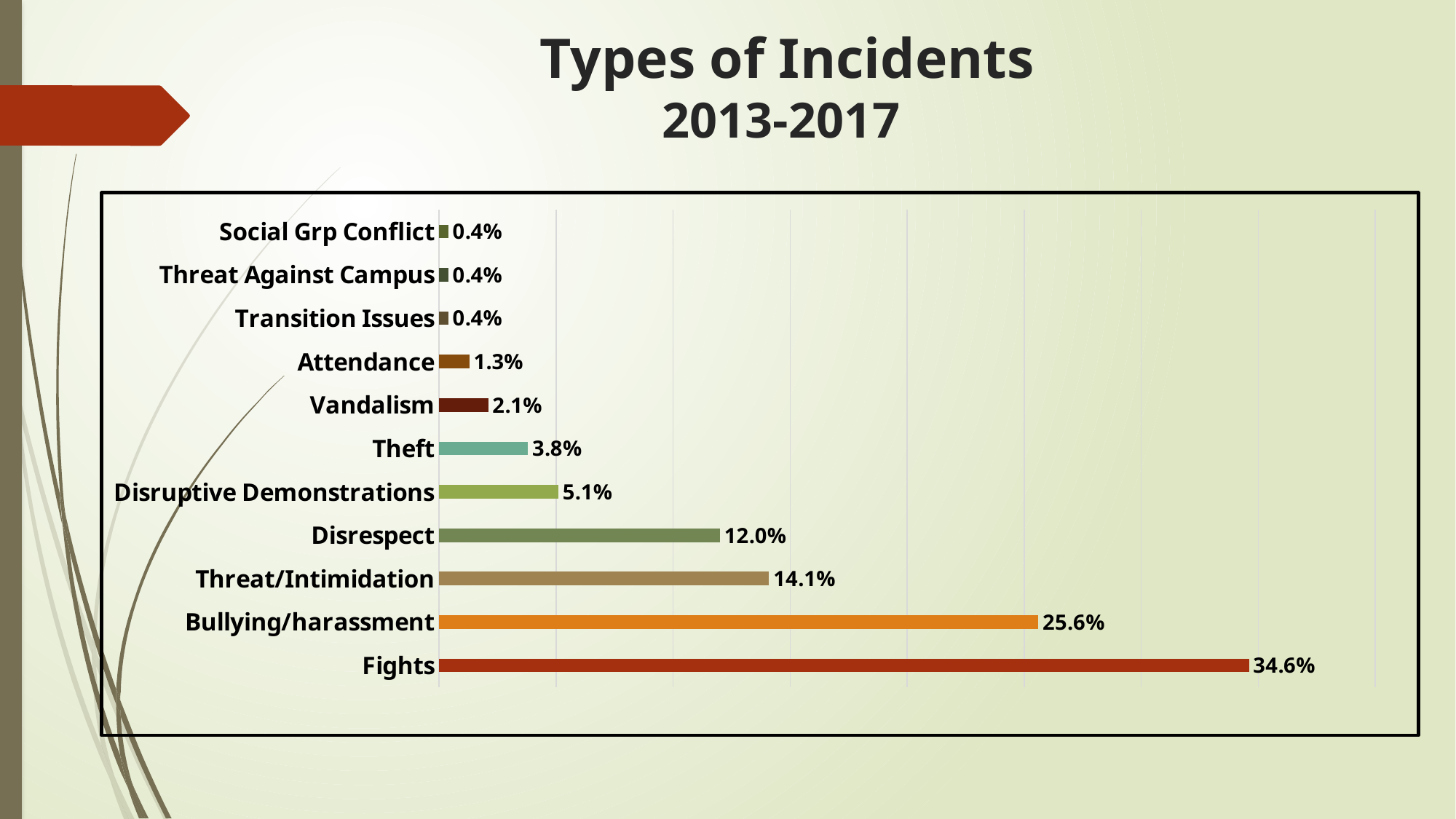
What is the value shown for Bullying/harassment? 25.6% What is the title of the slide? Types of Incidents 2013-2017 What is the value for Disruptive Demonstrations? 5.1% How many incident types have a value of 0.4%? 3 What is the difference between the percentages for Fights and Bullying/harassment? 9.0% What percentage is shown for Theft? 3.8% Which type of incident has the highest percentage? Fights Which is larger, the value for Vandalism or the value for Attendance? Vandalism How many incident types are shown in the chart? 11 What percentage of incidents were Fights? 34.6% What kind of chart is shown on the slide? Bar chart What is the difference between the values for Threat/Intimidation and Disrespect? 2.1%